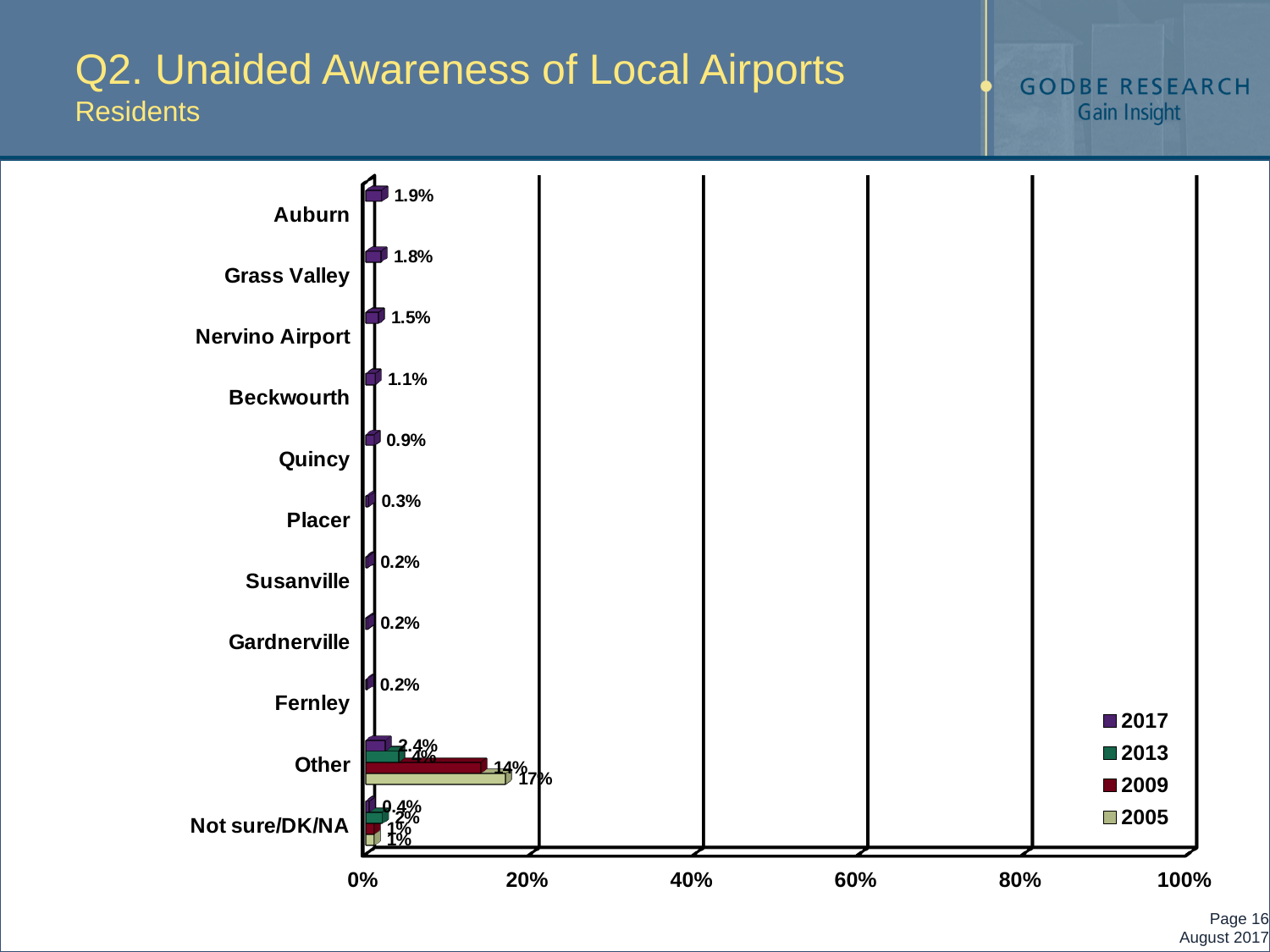
What is the 2017 value for Placer? 0.3% How many series does the legend list? 4 What kind of chart is shown on the slide? Bar chart What is the difference between the 2005 and 2009 values for Other? 3 percentage points What is the 2005 value for Other? 17% How many categories are shown on the chart? 11 What is the 2017 value for Nervino Airport? 1.5% What is the 2017 value for Auburn? 1.9% Which is larger in 2017, the value for Auburn or the value for Quincy? Auburn What is the 2009 value for Other? 14% What is the 2017 value for Beckwourth? 1.1% What is the 2017 value for Grass Valley? 1.8%